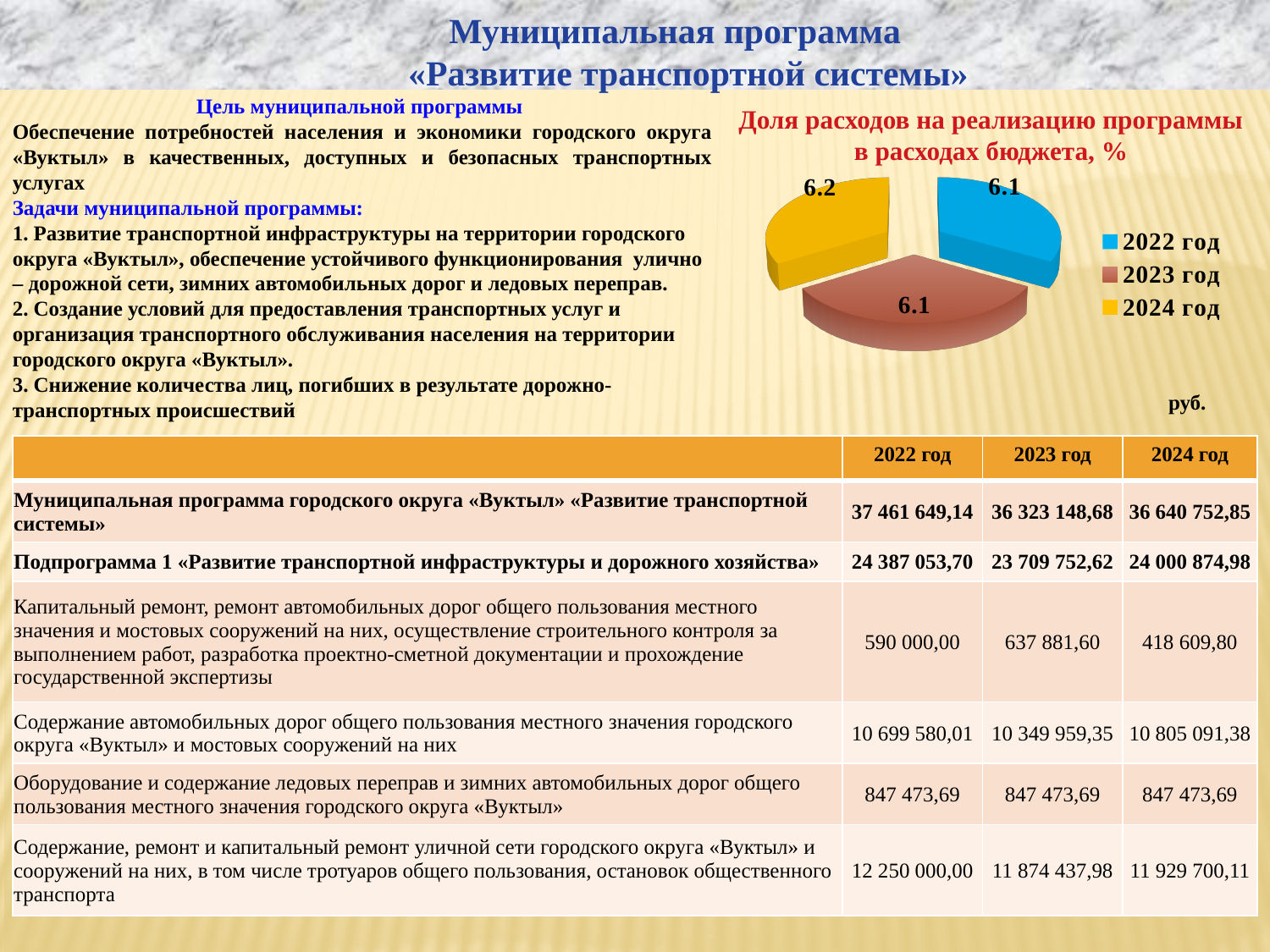
Which is larger in the pie chart, the value for 2024 год or the value for 2023 год? 2024 год What is the title of the pie chart? Доля расходов на реализацию программы в расходах бюджета, % How many slices does the pie chart have? 3 What type of chart is shown on the slide? Pie chart What colour is the 2022 год slice in the pie chart? Blue What value is shown for the 2022 год slice in the pie chart? 6.1 What is the difference between the values for 2024 год and 2022 год in the pie chart? 0.1 Which year has the highest value in the pie chart? 2024 год How many entries does the legend of the pie chart list? 3 What value is shown for the 2024 год slice in the pie chart? 6.2 What value is shown for the 2023 год slice in the pie chart? 6.1